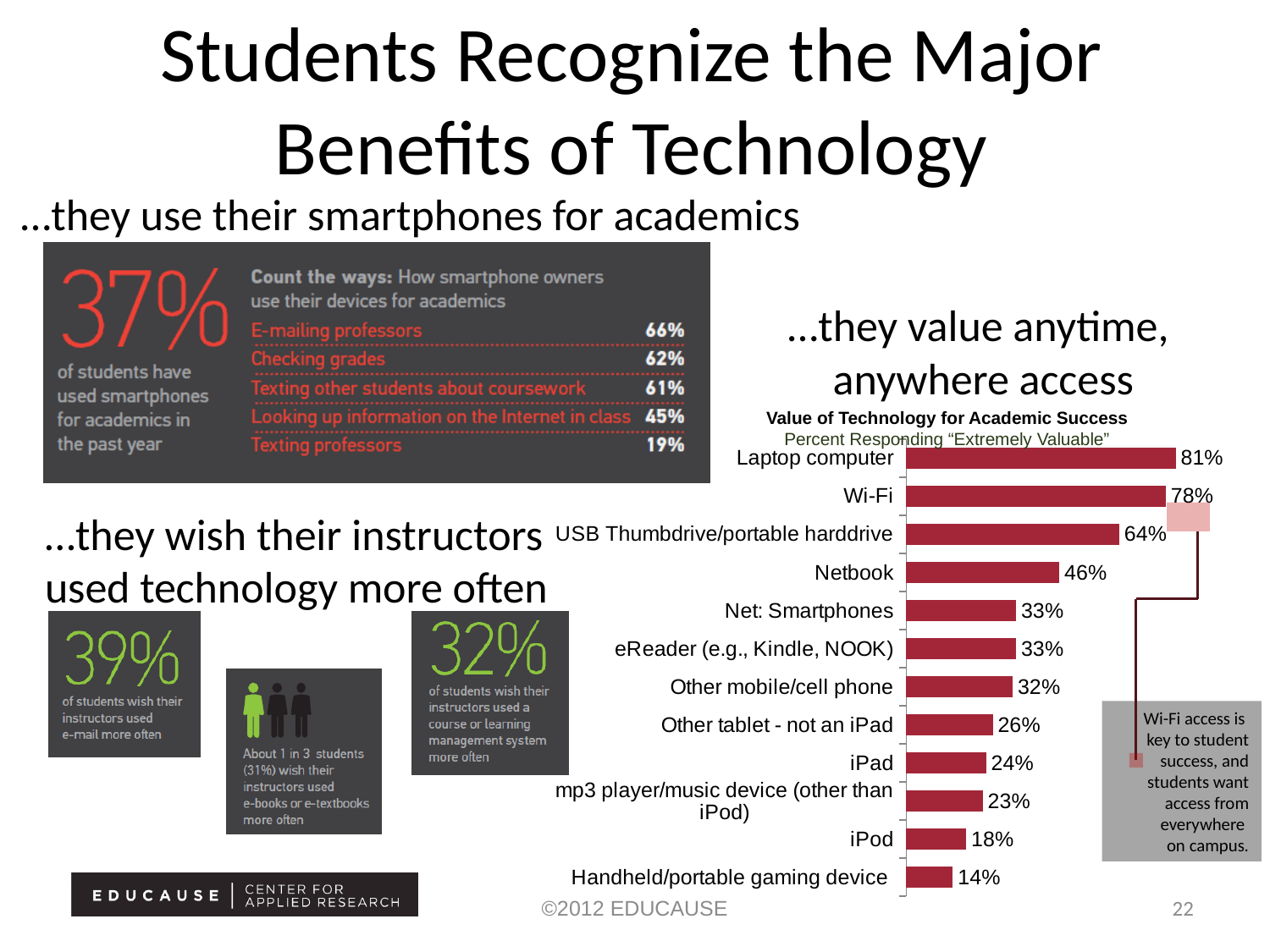
In the 'Value of Technology for Academic Success' chart, what is the subtitle shown under the chart title? Percent Responding "Extremely Valuable" In the 'Value of Technology for Academic Success' chart, which category has the highest value? Laptop computer In the 'Value of Technology for Academic Success' chart, what is the difference between the values for Netbook and iPod? 28% In the 'Value of Technology for Academic Success' chart, what is the difference between the values for Laptop computer and Wi-Fi? 3% In the 'Value of Technology for Academic Success' chart, what is the value for Netbook? 46% In the 'Value of Technology for Academic Success' chart, what is the value for Wi-Fi? 78% What kind of chart is the 'Value of Technology for Academic Success' chart? Bar chart In the 'Value of Technology for Academic Success' chart, which category has the lowest value? Handheld/portable gaming device In the 'Value of Technology for Academic Success' chart, which has a larger value, iPad or Other tablet - not an iPad? Other tablet - not an iPad How many categories are shown in the 'Value of Technology for Academic Success' chart? 12 In the 'Value of Technology for Academic Success' chart, what is the value for iPod? 18% In the 'Value of Technology for Academic Success' chart, what percentage of students rated the laptop computer as extremely valuable? 81%